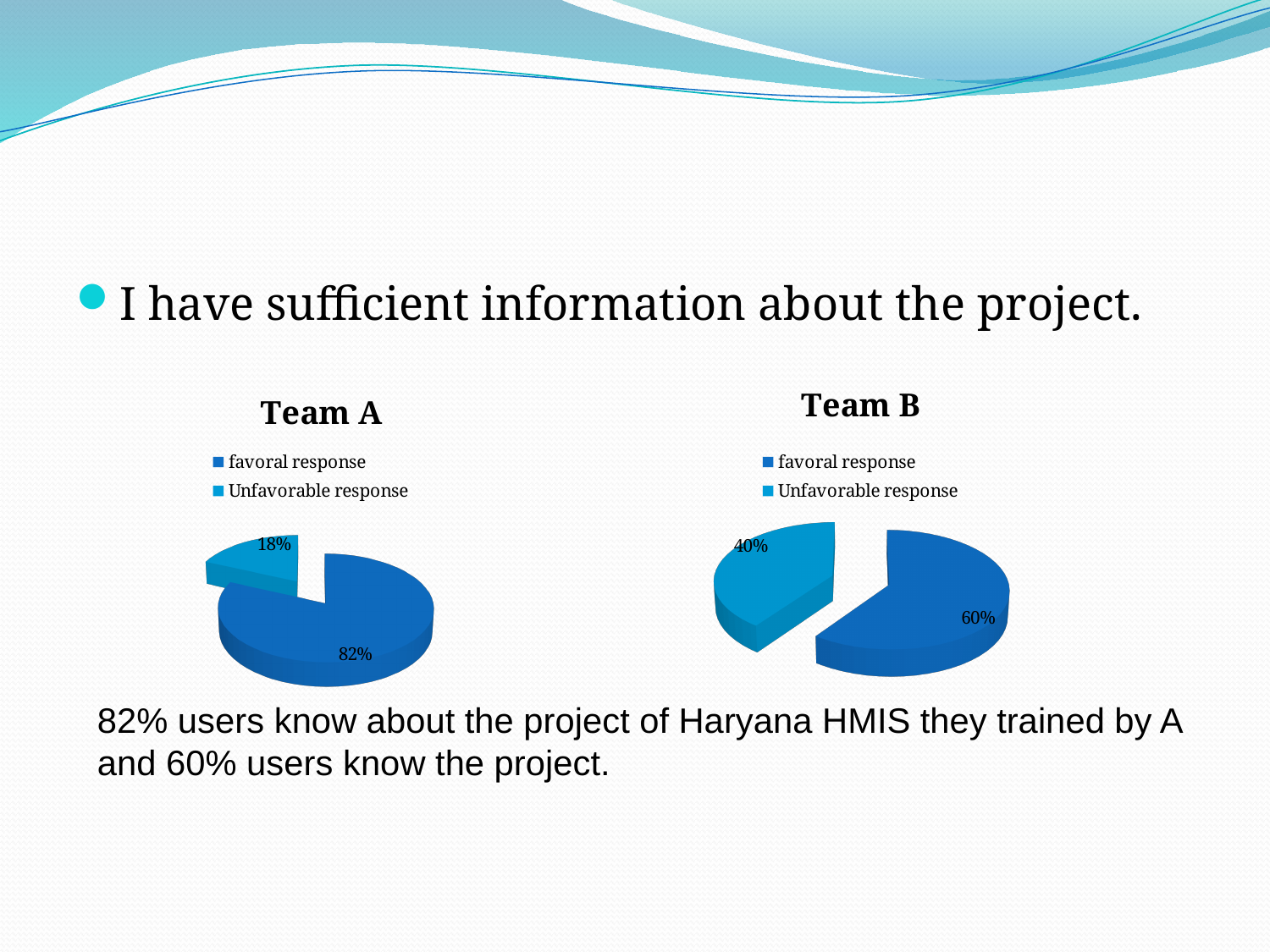
What kind of chart is the Team B chart? Pie chart In the Team A chart, what share of the pie is the favoral response slice? 82% In the Team B chart, what share of the pie is the favoral response slice? 60% In the Team B chart, what share of the pie is the Unfavorable response slice? 40% Which chart has the larger favoral response share, Team A or Team B? Team A In the Team B chart, what is the difference between the favoral response and Unfavorable response shares? 20% In the Team A chart, which slice is the largest? favoral response How many entries does the legend of the Team B chart list? 2 In the Team B chart, which slice is the smallest? Unfavorable response How many slices does the Team A chart have? 2 In the Team A chart, what is the difference between the favoral response and Unfavorable response shares? 64%